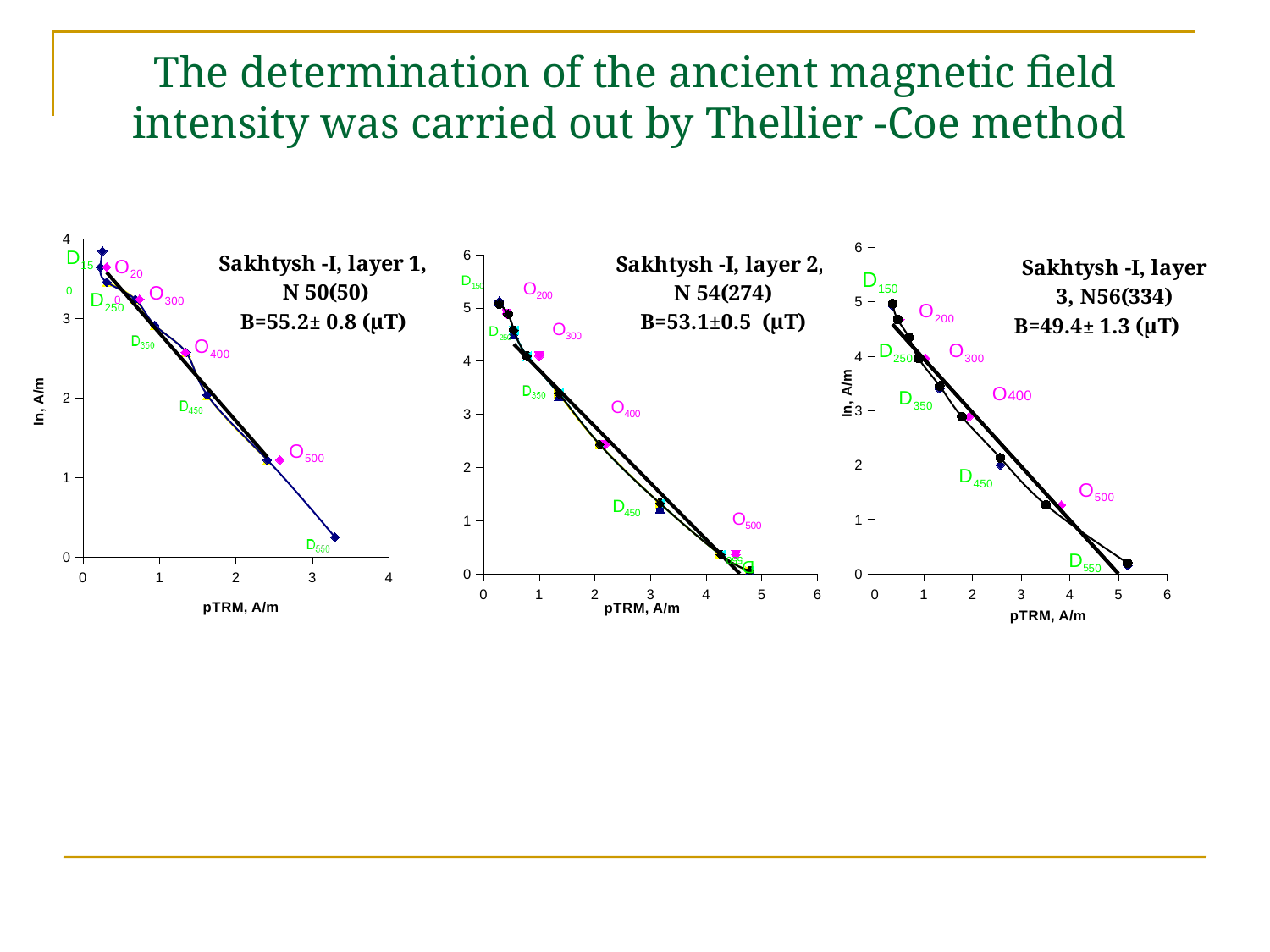
In the right chart 'Sakhtysh -I, layer 3', is the pTRM value for the D550 point greater or less than 5? greater In the right chart 'Sakhtysh -I, layer 3', do the In values rise or fall as pTRM increases? fall What is the x-axis label of the middle chart 'Sakhtysh -I, layer 2'? pTRM, A/m In the left chart 'Sakhtysh -I, layer 1', is the In value for the O500 point greater or less than 1? greater What kind of chart is the left chart, 'Sakhtysh -I, layer 1'? scatter (line) chart In the right chart 'Sakhtysh -I, layer 3', which labelled point has the highest In value? D150 In the left chart 'Sakhtysh -I, layer 1', do the In values rise or fall as pTRM increases? fall What B value is stated on the right chart 'Sakhtysh -I, layer 3'? B=49.4± 1.3 (µT) In the left chart 'Sakhtysh -I, layer 1', is the In value for the D550 point greater or less than 1? less How many charts are shown on the slide? 3 In the left chart 'Sakhtysh -I, layer 1', which labelled point has the lowest In value? D550